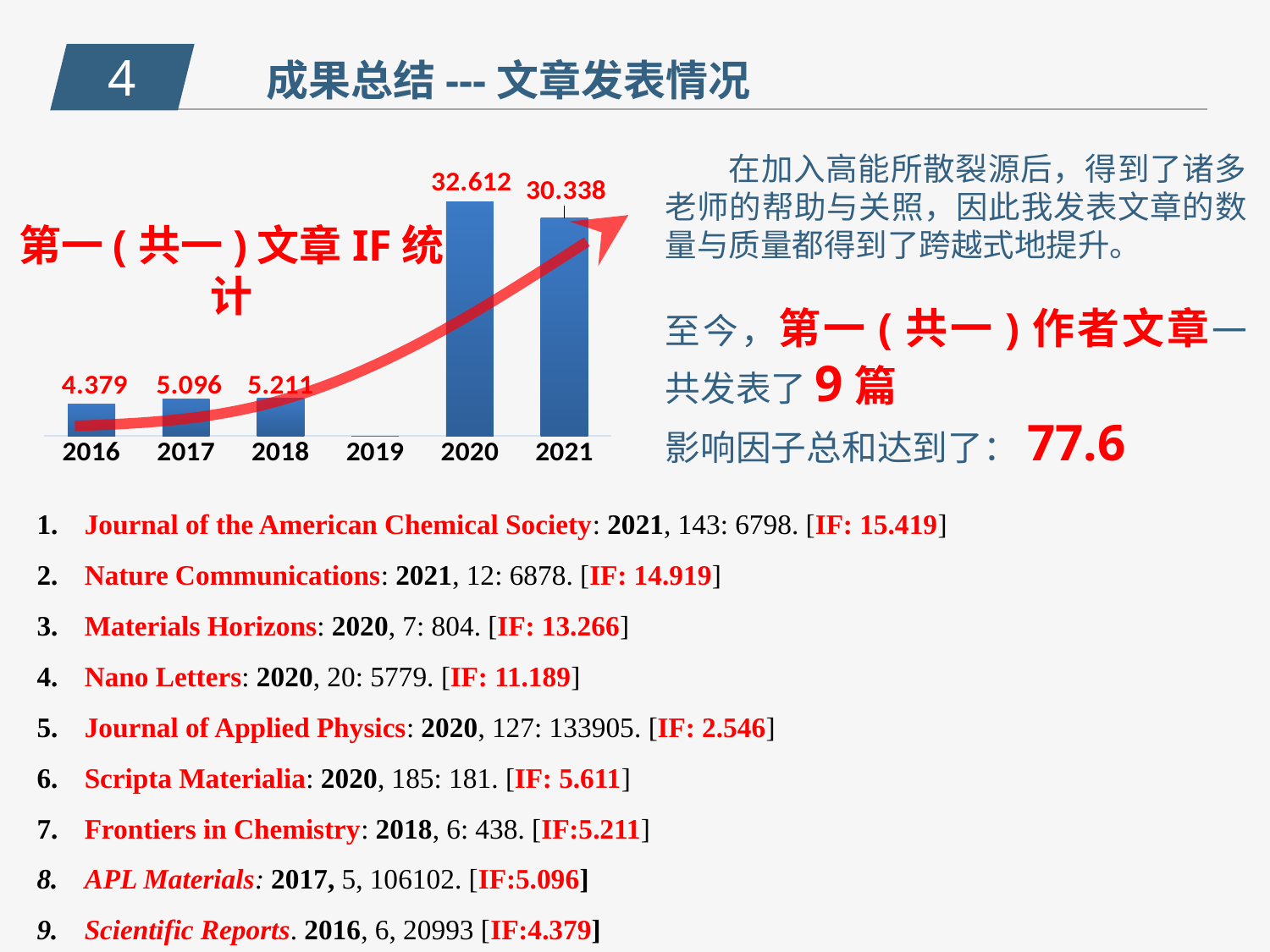
What is the title of the chart on the slide? 第一（共一）文章 IF 统计 Do the values in the chart generally rise or fall from 2016 to 2020? Rise Which is larger in the chart, the value for 2017 or the value for 2018? 2018 What is the difference between the values for 2020 and 2021 in the chart? 2.274 How many year categories are shown on the x axis of the chart? 6 What is the value for 2020 in the chart? 32.612 What kind of chart is shown on the slide? Bar chart Which year has the highest value in the chart? 2020 What is the value for 2018 in the chart? 5.211 What is the value for 2016 in the chart? 4.379 What is the value for 2021 in the chart? 30.338 Which year has the lowest value among the years with a labelled bar in the chart? 2016